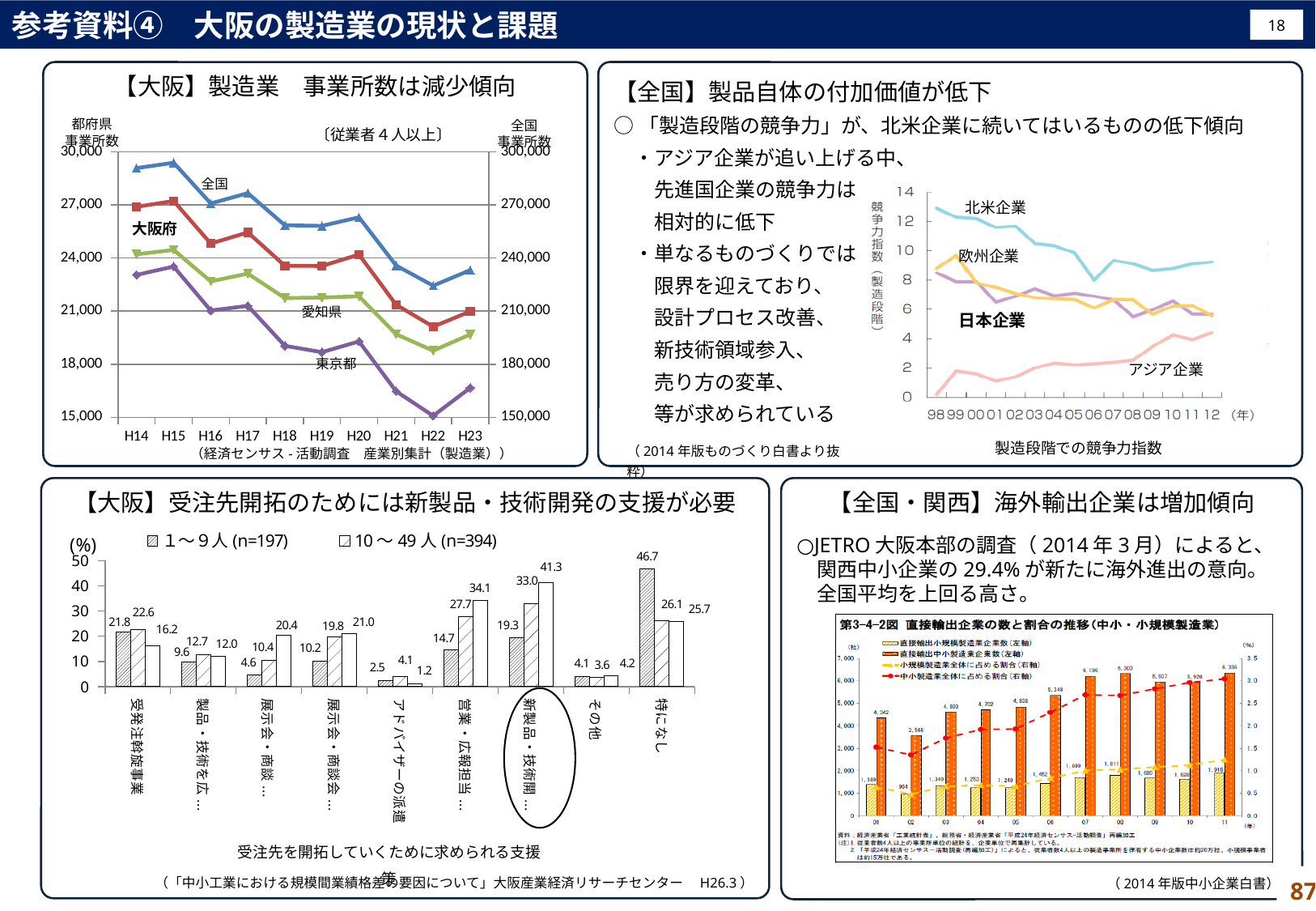
In the bottom-left bar chart (受注先を開拓していくために求められる支援策), how many series does the legend list? 2 In the top-left chart (事業所数), how many years are shown on the x axis? 10 In the top-right chart 製造段階での競争力指数, does the アジア企業 line rise or fall from 98 to 12? rise In the top-left chart (事業所数), does the 大阪府 line rise or fall from H14 to H23? fall In the bottom-right chart 直接輸出企業の数と割合の推移, how many series does the legend list? 4 In the bottom-left bar chart (受注先を開拓していくために求められる支援策), how many categories are shown on the x axis? 9 In the top-left chart (事業所数), is the value for 東京都 at H22 greater or less than 18,000? less What kind of chart is the top-left chart titled 【大阪】製造業 事業所数は減少傾向? line chart In the bottom-left bar chart (受注先を開拓していくために求められる支援策), what is the highest value labeled on any bar? 46.7 In the top-right chart 製造段階での競争力指数, which company group has the highest index across the period? 北米企業 In the top-left chart (事業所数), is the value for 大阪府 at H14 greater or less than 24,000? greater In the top-left chart (事業所数), which of the three prefecture lines (大阪府, 愛知県, 東京都) is lowest across the period? 東京都